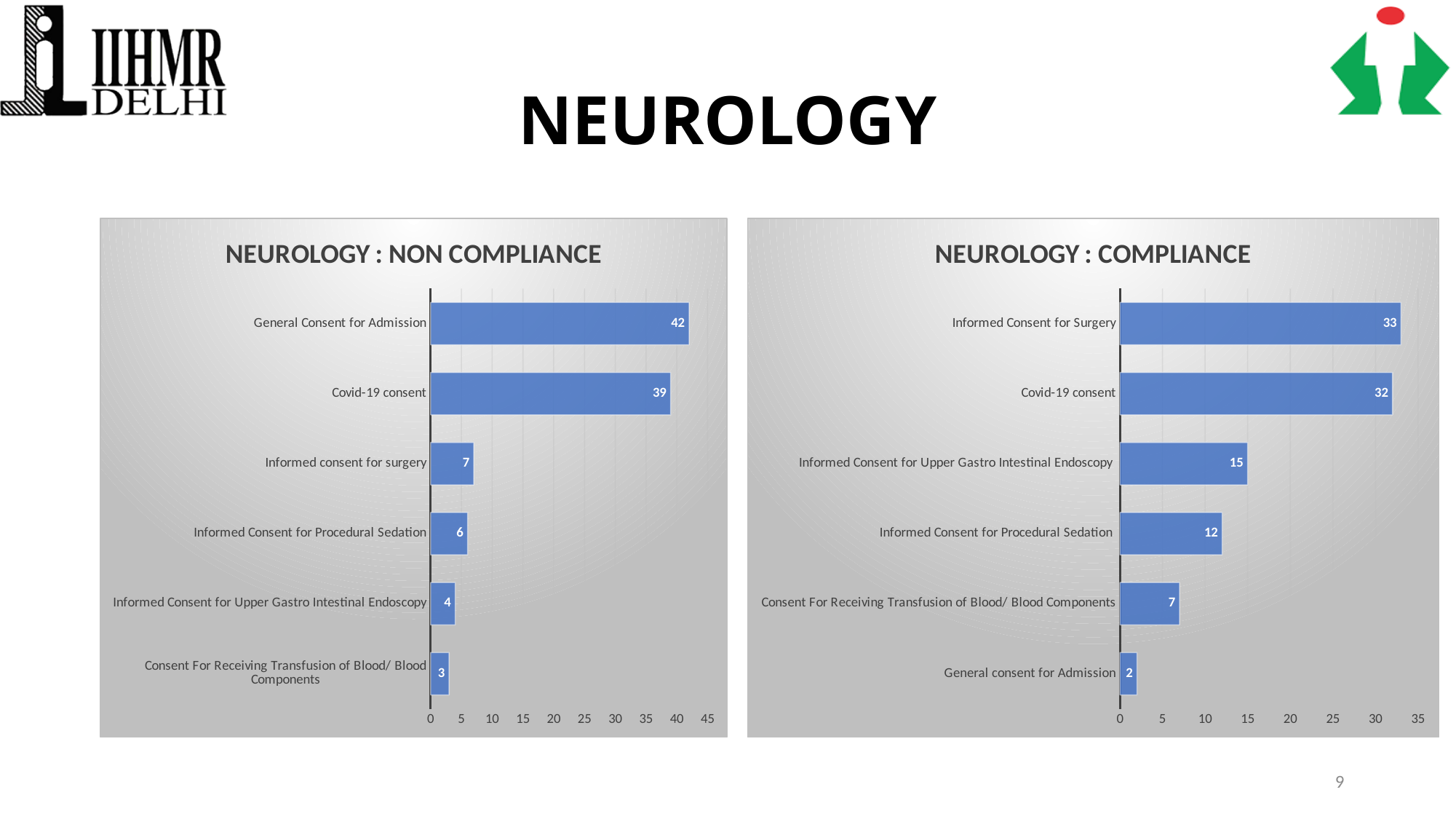
In the NEUROLOGY : NON COMPLIANCE chart, what is the value for General Consent for Admission? 42 How many categories are shown in the NEUROLOGY : COMPLIANCE chart? 6 In the NEUROLOGY : COMPLIANCE chart, what is the value for Informed Consent for Upper Gastro Intestinal Endoscopy? 15 In the NEUROLOGY : COMPLIANCE chart, which is larger: the value for Covid-19 consent or the value for Informed Consent for Procedural Sedation? Covid-19 consent In the NEUROLOGY : COMPLIANCE chart, what is the difference between the values for Informed Consent for Procedural Sedation and General consent for Admission? 10 What is the title of the chart on the right side of the slide? NEUROLOGY : COMPLIANCE In the NEUROLOGY : NON COMPLIANCE chart, which category has the lowest value? Consent For Receiving Transfusion of Blood/ Blood Components In the NEUROLOGY : COMPLIANCE chart, which category has the highest value? Informed Consent for Surgery What kind of chart is the NEUROLOGY : NON COMPLIANCE chart? Bar chart In the NEUROLOGY : NON COMPLIANCE chart, what is the value for Informed Consent for Procedural Sedation? 6 In the NEUROLOGY : NON COMPLIANCE chart, is the value for Covid-19 consent greater or less than 35? greater In the NEUROLOGY : NON COMPLIANCE chart, what is the difference between the values for General Consent for Admission and Covid-19 consent? 3